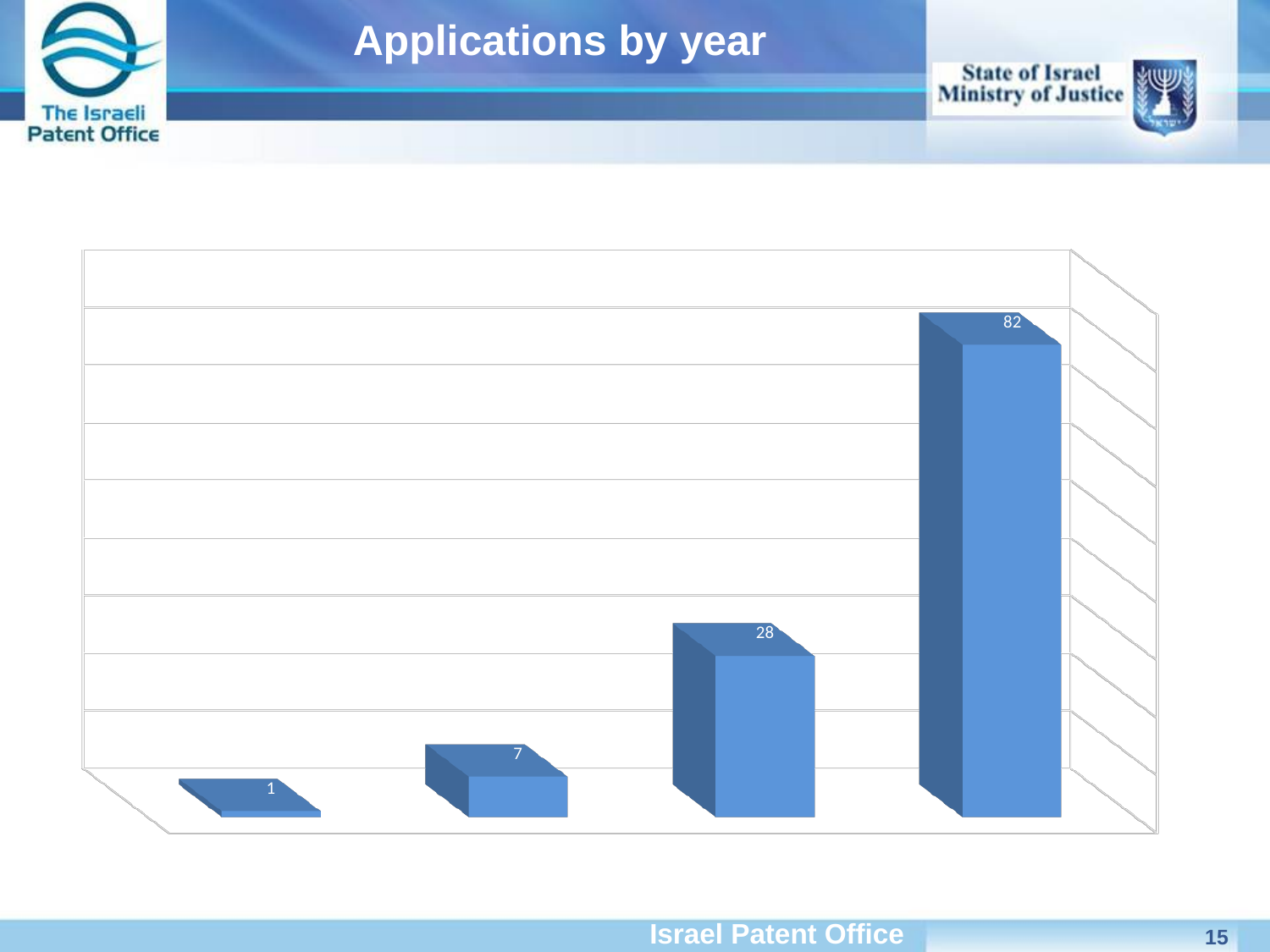
Which is larger, the value of the third bar or the second bar? The third bar (28) What is the difference between the values of the second and first bars? 6 What value is shown on the rightmost bar? 82 Which bar has the lowest value? The leftmost (first) bar, 1 Which bar has the highest value? The rightmost (fourth) bar, 82 What value is shown on the second bar from the left? 7 How many bars are plotted in the chart? 4 What value is shown on the third bar from the left? 28 Do the values rise or fall from left to right across the bars? Rise What kind of chart is shown on the slide? Bar chart What value is shown on the first bar from the left? 1 What is the difference between the values of the rightmost bar and the third bar? 54